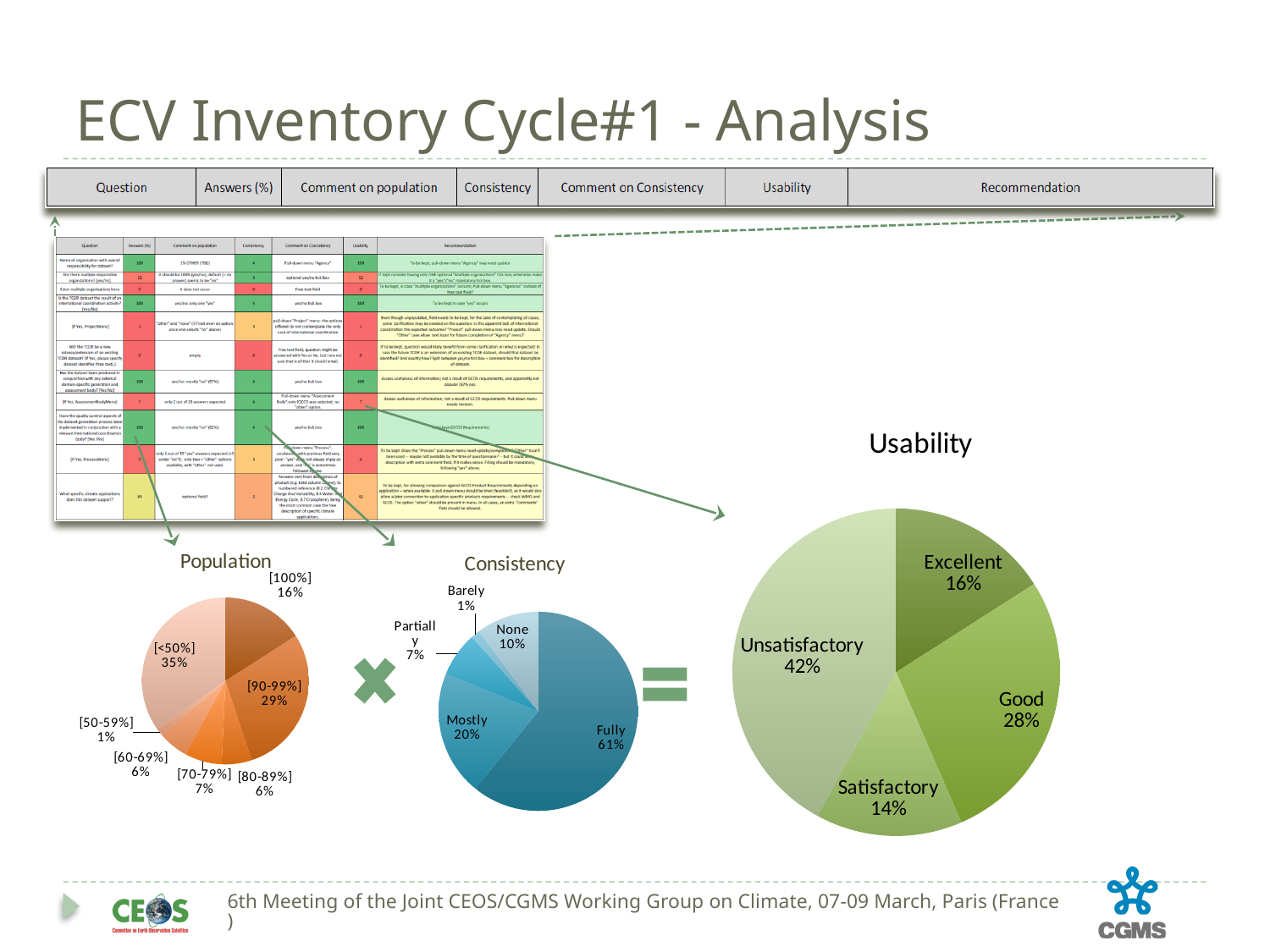
In the Usability pie chart, which is larger, Good or Excellent? Good How many slices does the Population pie chart have? 7 In the Consistency pie chart, which category has the largest share? Fully In the Population pie chart, which category has the smallest share? [50-59%] In the Population pie chart, what share is labelled [<50%]? 35% In the Usability pie chart, what share is labelled Unsatisfactory? 42% In the Population pie chart, what share is labelled [90-99%]? 29% In the Consistency pie chart, what share is labelled Fully? 61% What type of chart is the Usability chart? Pie chart How many slices does the Consistency pie chart have? 5 In the Usability pie chart, what is the difference between the Unsatisfactory and Satisfactory shares? 28% In the Consistency pie chart, what is the difference between the Mostly and None shares? 10%